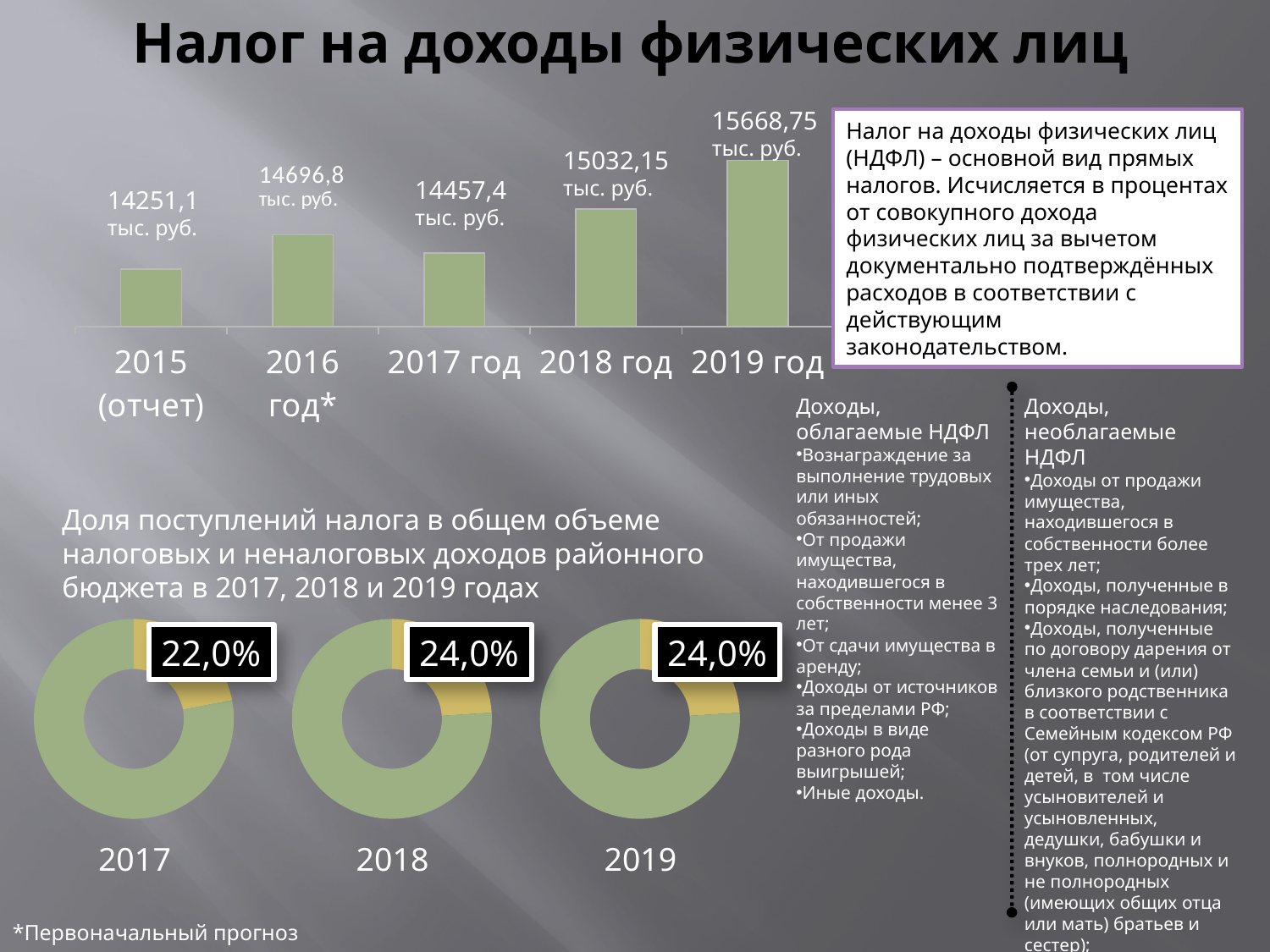
In the bar chart at the top, what is the difference between the values for 2016 год* and 2017 год? 239,4 тыс. руб. In the donut chart for 2017 at the bottom, what share is shown for the highlighted slice? 22,0% In the bar chart at the top, which is larger: the value for 2016 год* or the value for 2017 год? 2016 год* What kind of chart is shown at the top of the slide? Bar chart In the bar chart at the top, what is the value for 2019 год? 15668,75 тыс. руб. In the donut chart for 2019 at the bottom, what share is shown for the highlighted slice? 24,0% In the bar chart at the top, which year has the lowest value? 2015 (отчет) In the bar chart at the top, what is the difference between the values for 2019 год and 2018 год? 636,6 тыс. руб. How many bars are shown in the bar chart at the top? 5 In the bar chart at the top, which year has the highest value? 2019 год In the bar chart at the top, what is the value for 2015 (отчет)? 14251,1 тыс. руб. In the bar chart at the top, what is the value for 2018 год? 15032,15 тыс. руб.